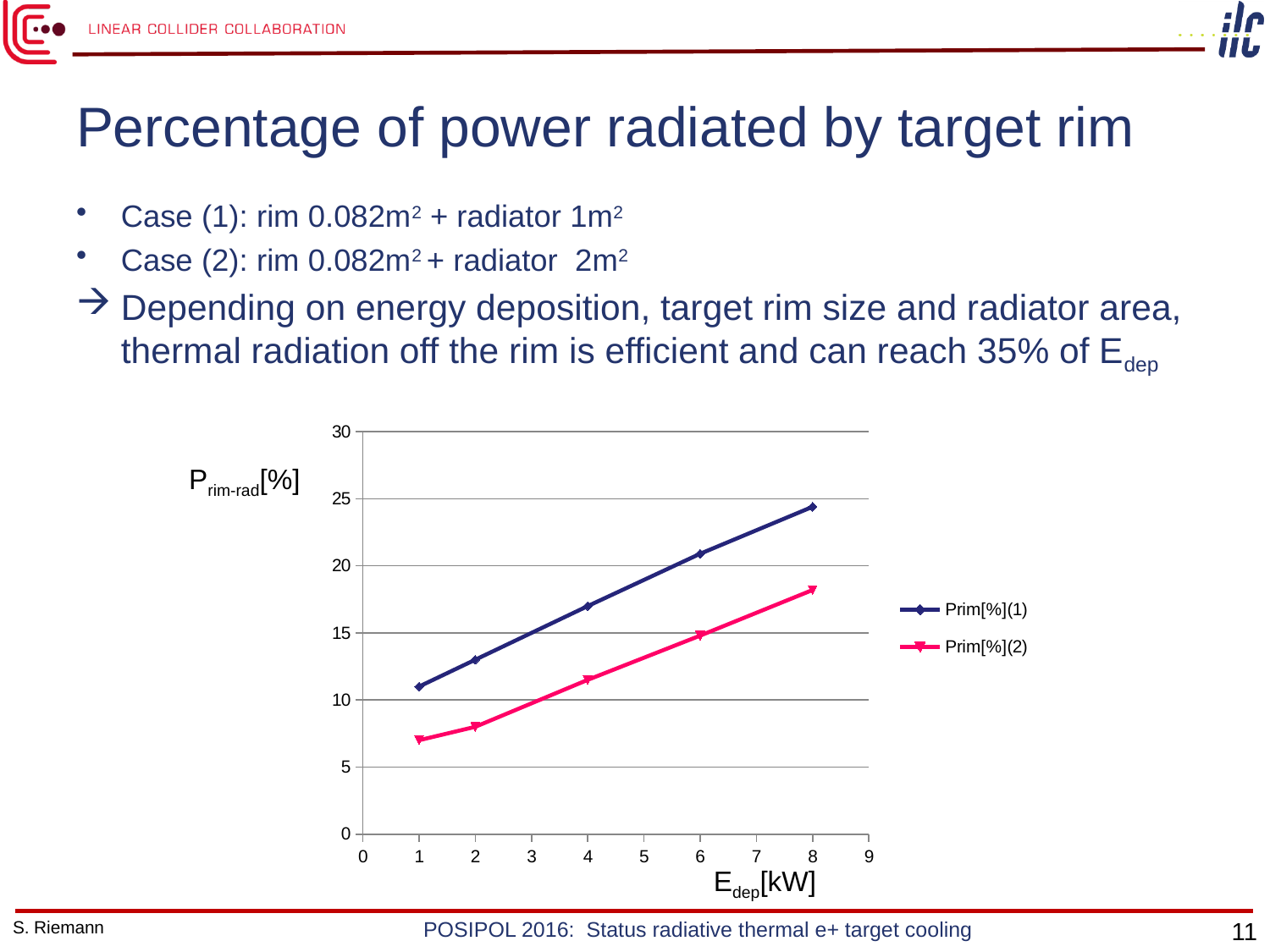
What kind of chart is shown on the slide? line chart How many data points are plotted for the Prim[%](1) series? 5 Is the Prim[%](1) value at E_dep = 8 kW greater or less than 20? greater What is the label of the x axis of the chart? E_dep[kW] At E_dep = 8 kW, which series has the higher value, Prim[%](1) or Prim[%](2)? Prim[%](1) Is the Prim[%](1) value at E_dep = 4 kW greater or less than 15? greater Is the Prim[%](2) value at E_dep = 4 kW greater or less than 15? less Do the Prim[%](1) values rise or fall as E_dep increases along the x axis? rise Do the Prim[%](2) values rise or fall as E_dep increases along the x axis? rise How many series does the chart legend list? 2